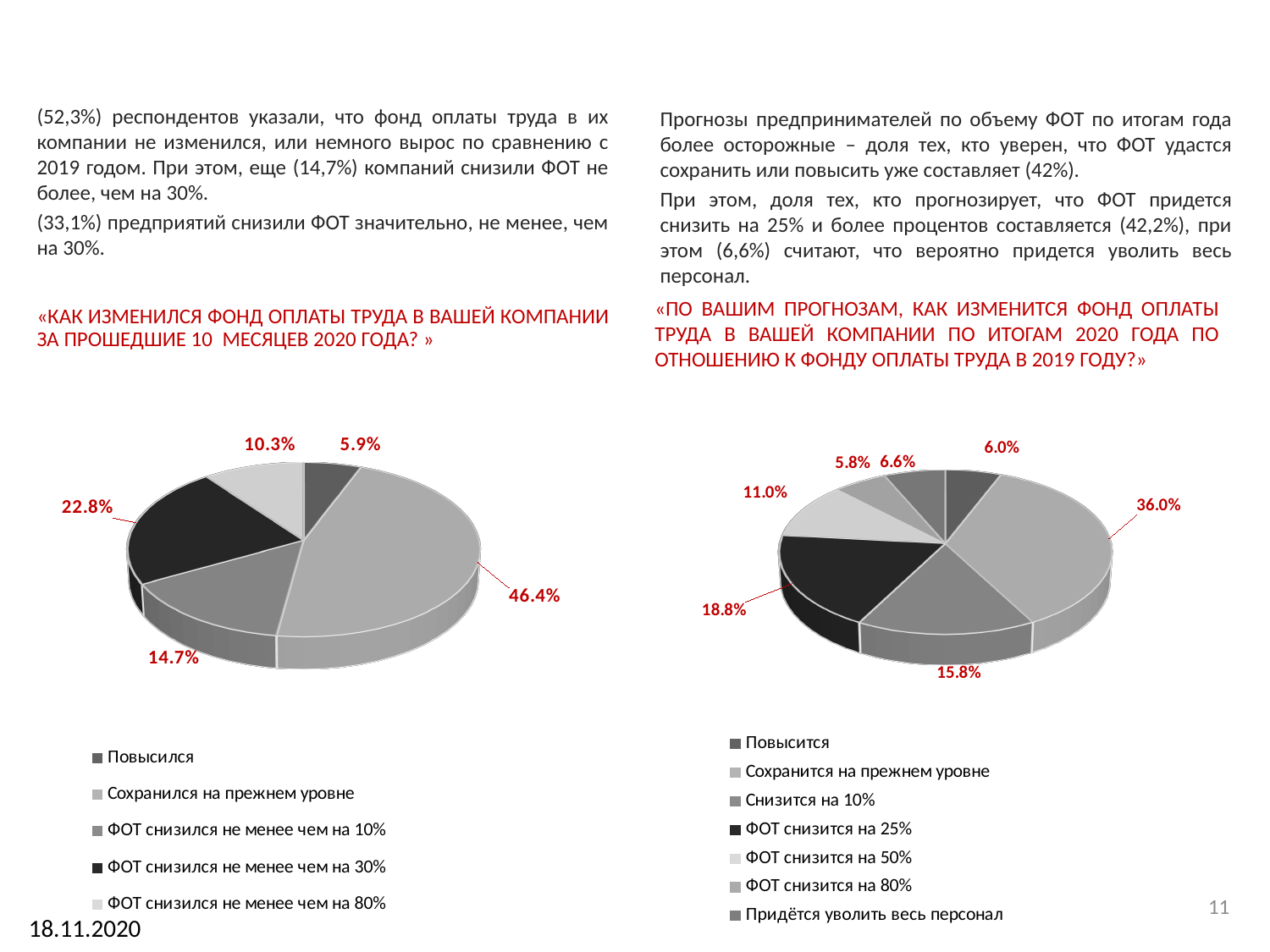
In the right pie chart, what is the smallest labelled value? 5.8% What type of chart is the left chart on the slide? Pie chart In the left pie chart, what is the value for 'ФОТ снизился не менее чем на 30%'? 22.8% In the left pie chart, what is the difference between the 22.8% slice and the 14.7% slice? 8.1% How many categories does the legend of the right pie chart list? 7 In the right pie chart, which is larger: the slice for 'ФОТ снизится на 25%' or the slice for 'Снизится на 10%'? ФОТ снизится на 25% In the right pie chart, what is the value for 'Придётся уволить весь персонал'? 6.6% In the right pie chart, what is the value for 'Сохранится на прежнем уровне'? 36.0% How many categories does the legend of the left pie chart list? 5 In the right pie chart, what is the difference between the 18.8% slice and the 11.0% slice? 7.8% In the left pie chart, what share is labelled for the largest slice? 46.4% In the left pie chart, what is the value of the smallest slice? 5.9%